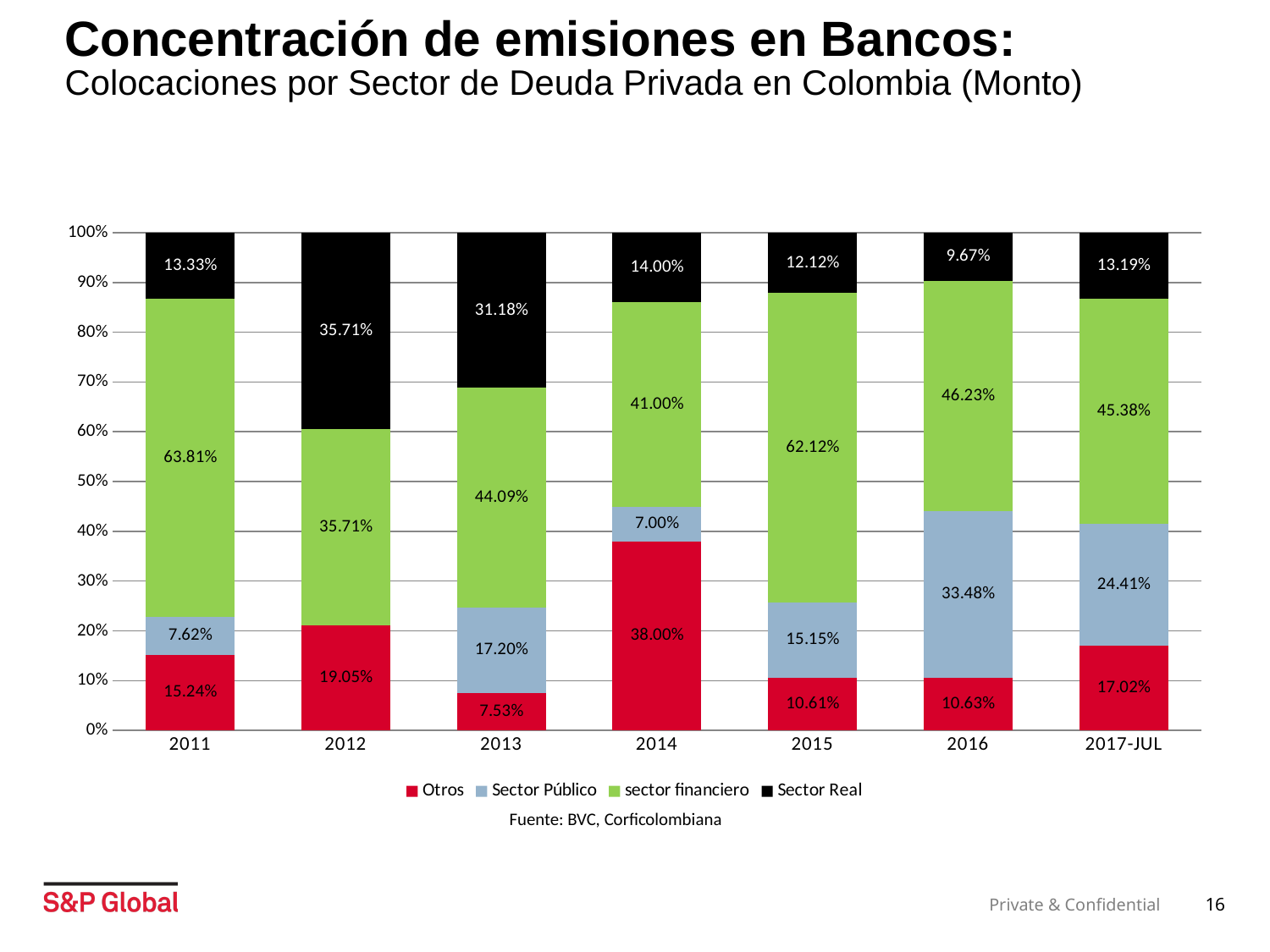
Which colour represents Sector Real in the chart? Black How many series does the legend list? 4 How many years are shown on the x axis? 7 In which year is the sector financiero share highest? 2011 Which is larger in 2017-JUL, Sector Público or Otros? Sector Público What is the value for sector financiero in 2011? 63.81% What is the value for Sector Público in 2016? 33.48% What is the value for Sector Real in 2013? 31.18% In which year is the Sector Real share lowest? 2016 What is the value for Otros in 2014? 38.00% What is the difference between Otros and Sector Público in 2014? 31.00% What kind of chart is shown on the slide? Stacked bar chart